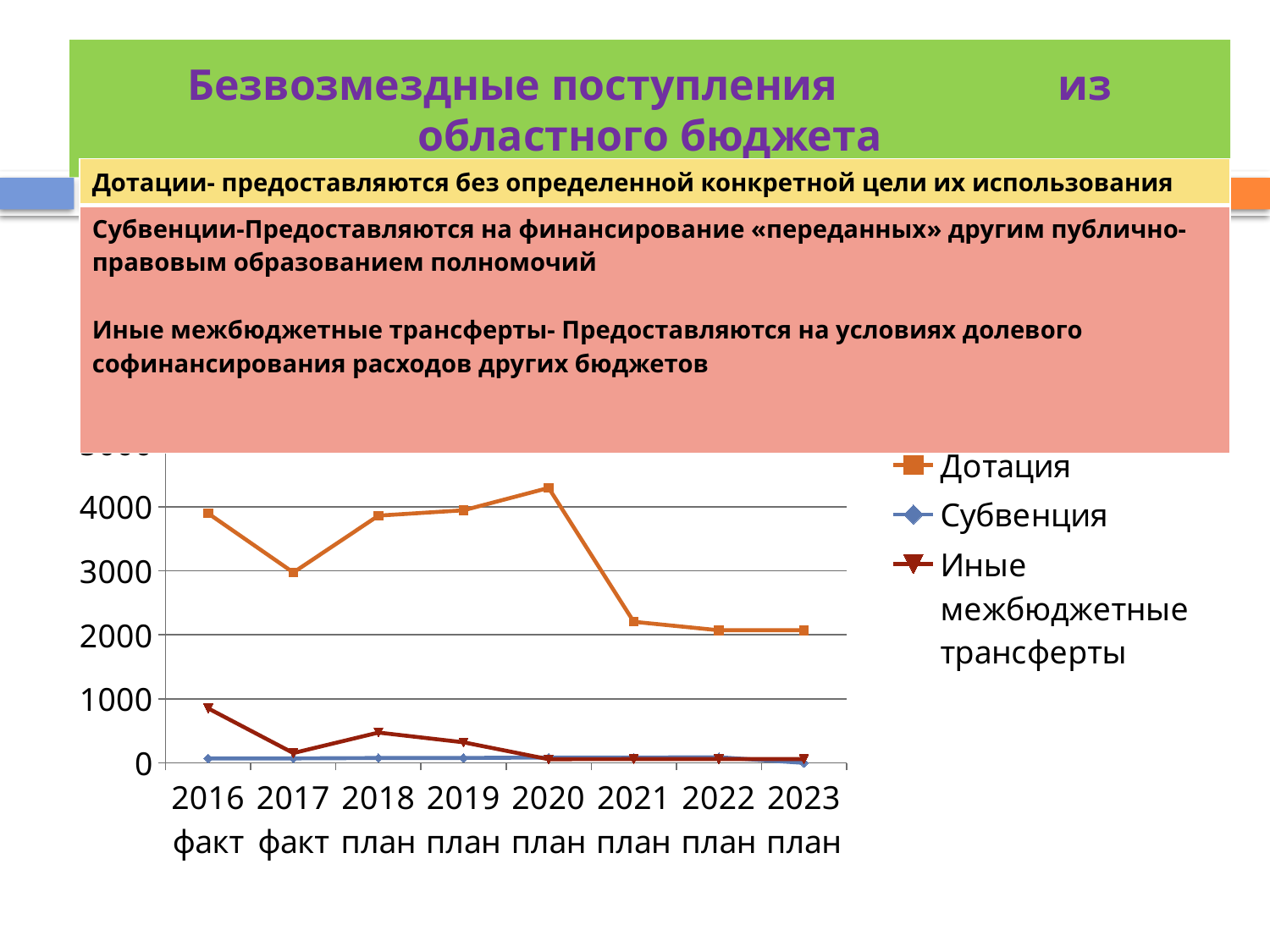
Is the value of Дотация for 2020 greater or less than 4000? greater How many series does the chart legend list? 3 Which series has the highest value in 2016? Дотация Is the value of Дотация for 2022 greater or less than 3000? less How many years are plotted along the x axis of the chart? 8 Is the value of Иные межбюджетные трансферты for 2016 greater or less than 1000? less In which year does the Дотация series reach its highest value? 2020 Does the Дотация series rise or fall from 2020 to 2023? fall Which is larger for Дотация: the value for 2016 or the value for 2017? 2016 What kind of chart is shown on the slide? line chart What colour is the Дотация line in the chart? orange